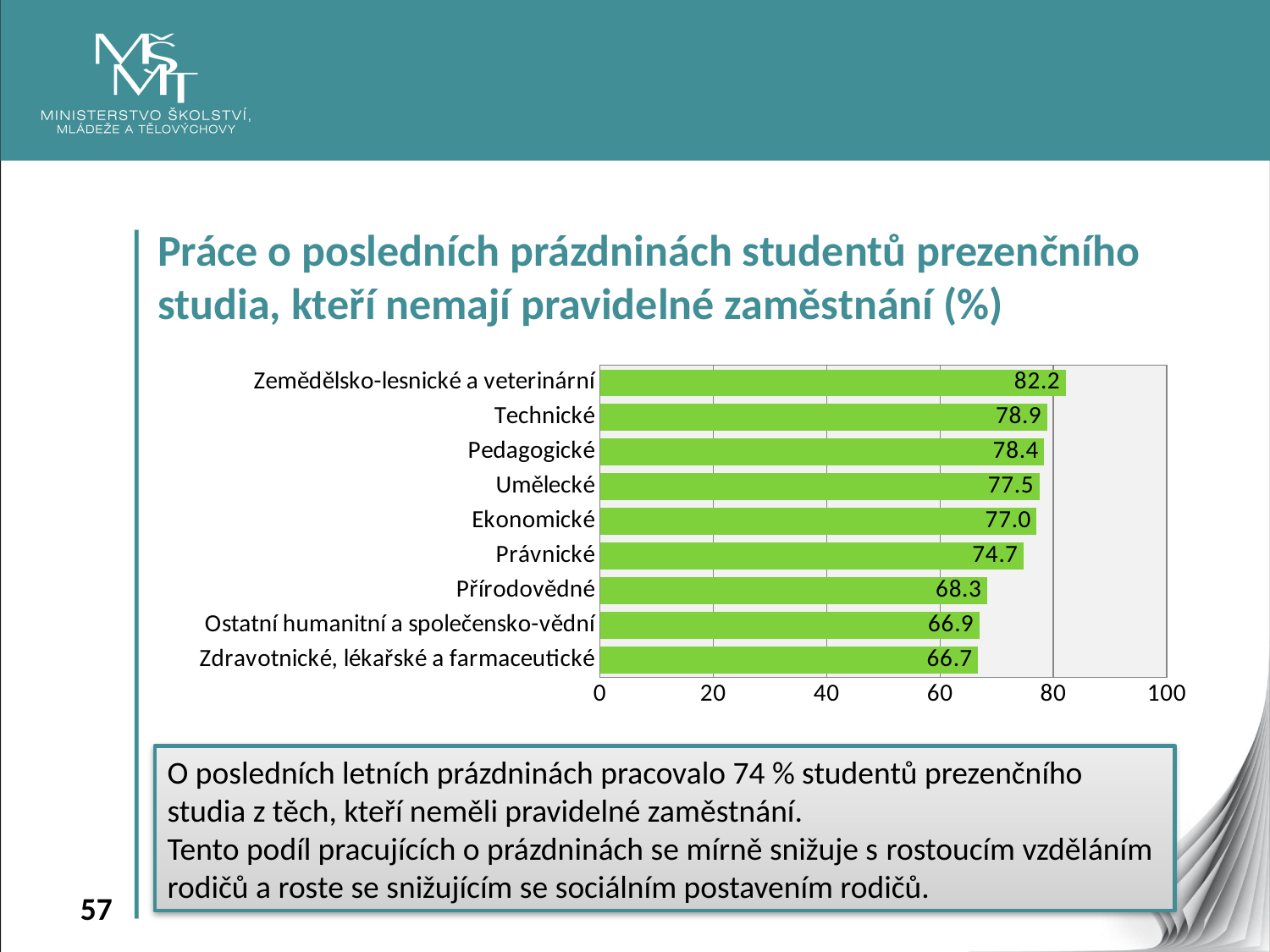
Is the value for Pedagogické greater or less than 80? less Which category has the highest value? Zemědělsko-lesnické a veterinární What is the maximum value shown on the horizontal axis? 100 How many categories are shown in the chart? 9 What colour are the bars in the chart? green What is the difference between the values for Zemědělsko-lesnické a veterinární and Právnické? 7.5 What is the value for Přírodovědné? 68.3 What is the value for Zdravotnické, lékařské a farmaceutické? 66.7 What kind of chart is shown on the slide? bar chart Which is larger, the value for Umělecké or the value for Ekonomické? Umělecké Which category has the lowest value? Zdravotnické, lékařské a farmaceutické What is the value for Technické? 78.9